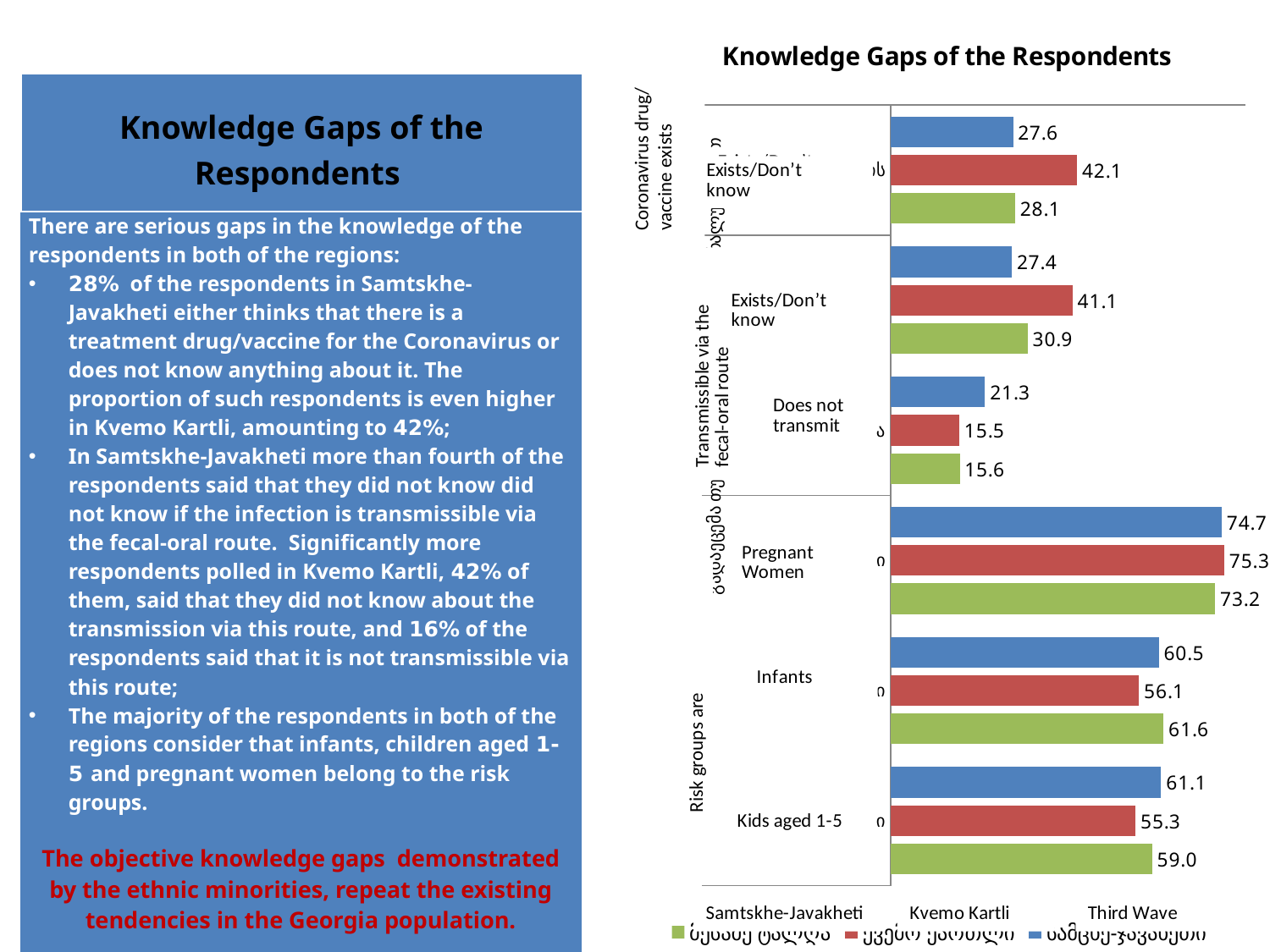
What is the Kvemo Kartli value for 'Exists/Don't know' under 'Coronavirus drug/vaccine exists'? 42.1 Which category has the highest Kvemo Kartli value? Pregnant Women What kind of chart is shown on the slide? bar chart How many categories are plotted on the chart? 6 What is the Kvemo Kartli value for Pregnant Women? 75.3 What is the title of the chart? Knowledge Gaps of the Respondents Which category has the lowest Kvemo Kartli value? Does not transmit What is the Kvemo Kartli value for Infants? 56.1 How many series does the chart's legend list? 3 What is the Kvemo Kartli value for 'Does not transmit'? 15.5 What is the difference between the Kvemo Kartli values for Pregnant Women and Infants? 19.2 What is the Kvemo Kartli value for Kids aged 1-5? 55.3